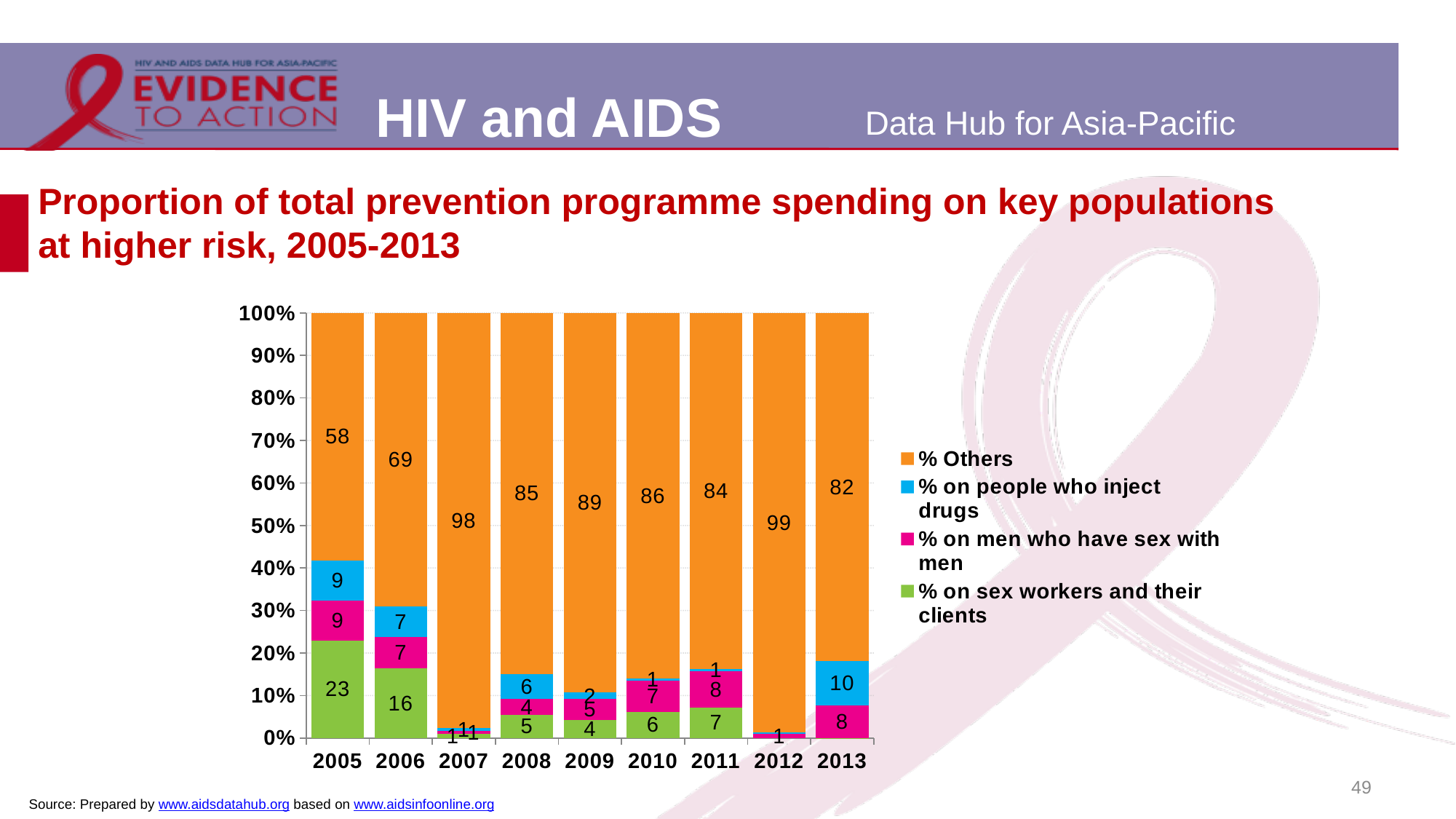
What kind of chart is shown on the slide? Stacked bar chart Which year has the highest value for % Others? 2012 What is the value for % on sex workers and their clients in 2005? 23 What is the difference between the % Others value in 2006 and in 2005? 11 Does the value for % Others rise or fall from 2005 to 2007? Rises What is the value for % Others in 2005? 58 Which year has the lowest value for % Others? 2005 How many series does the legend list? 4 How many years are shown on the x axis? 9 Which year has the larger value for % on sex workers and their clients, 2005 or 2006? 2005 What is the value for % on men who have sex with men in 2011? 8 What is the value for % on people who inject drugs in 2013? 10